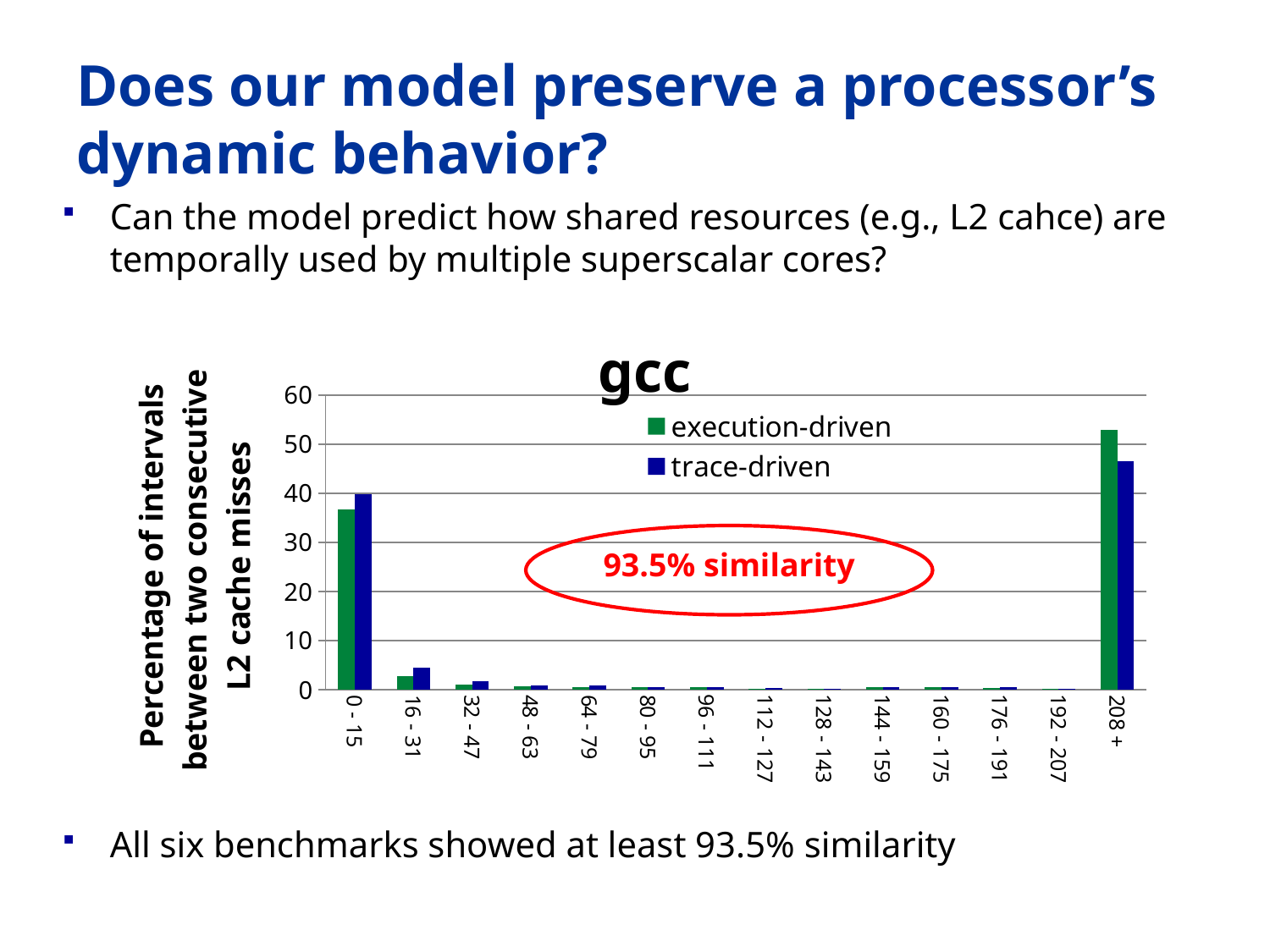
Is the trace-driven value for the 208 + interval greater or less than 50? less For the 208 + interval, which series has the larger value, execution-driven or trace-driven? execution-driven Which interval category has the highest trace-driven value in the gcc chart? 208 + Is the execution-driven value for the 16 - 31 interval greater or less than 10? less How many interval categories are shown along the x axis of the gcc chart? 14 Is the execution-driven value for the 0 - 15 interval greater or less than 30? greater For the 0 - 15 interval, which series has the larger value, execution-driven or trace-driven? trace-driven What similarity percentage is written in the red oval annotation on the gcc chart? 93.5% similarity What kind of chart is shown on the slide? bar chart How many series does the legend of the gcc chart list? 2 Which interval category has the highest execution-driven value in the gcc chart? 208 +